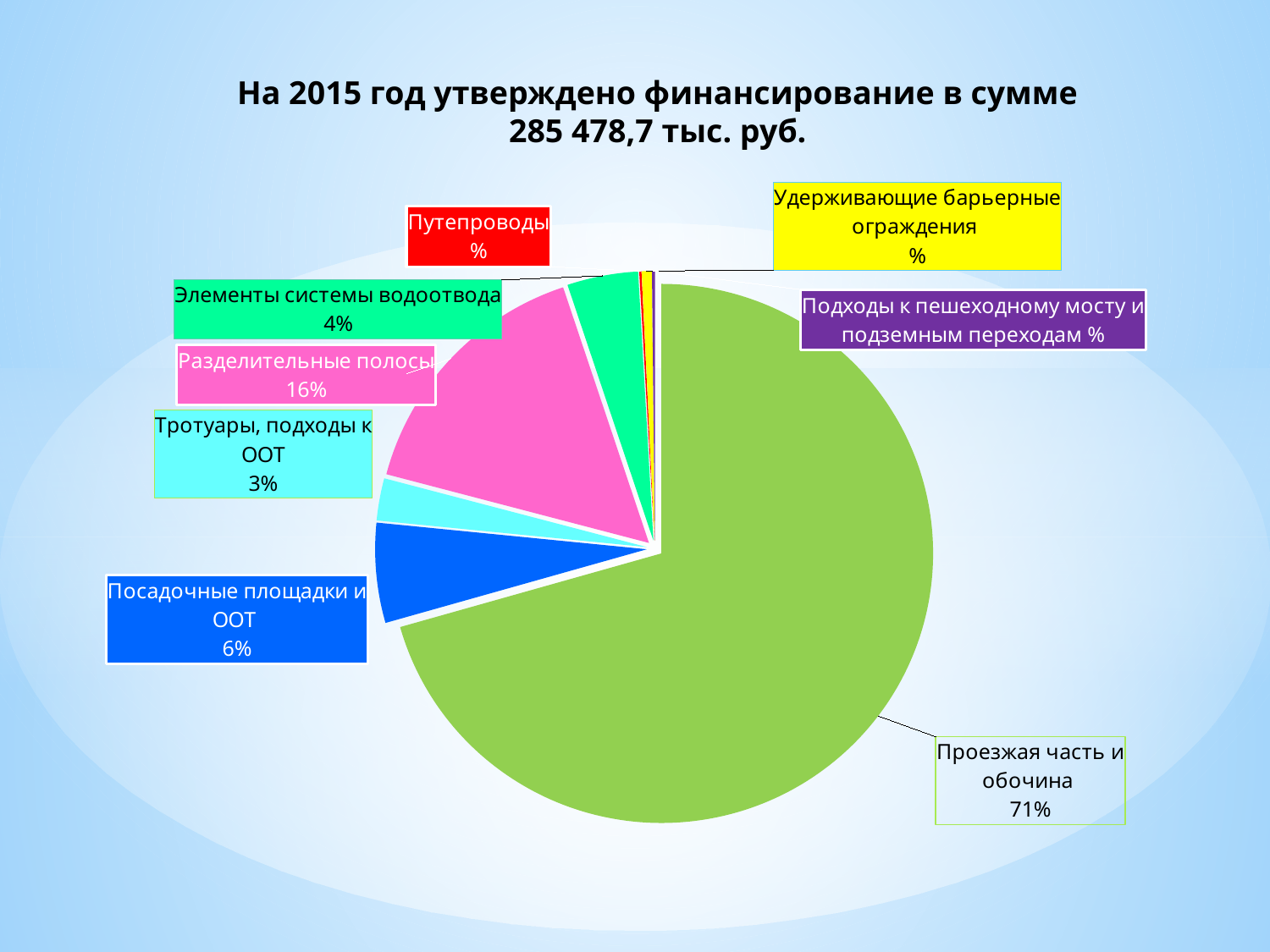
Which is larger: the share for "Разделительные полосы" or the share for "Посадочные площадки и ООТ"? Разделительные полосы What is the difference in percentage points between "Проезжая часть и обочина" and "Разделительные полосы"? 55 percentage points Which is larger: the share for "Элементы системы водоотвода" or the share for "Тротуары, подходы к ООТ"? Элементы системы водоотвода What share of the pie does "Посадочные площадки и ООТ" represent? 6% What share of the pie does "Элементы системы водоотвода" represent? 4% How many categories (slices) are labelled on the pie chart? 8 What total funding amount is stated in the slide title for 2015? 285 478,7 тыс. руб. What share of the pie does "Проезжая часть и обочина" represent? 71% Which category has the largest slice of the pie? Проезжая часть и обочина What kind of chart is shown on the slide? Pie chart What share of the pie does "Тротуары, подходы к ООТ" represent? 3% What share of the pie does "Разделительные полосы" represent? 16%